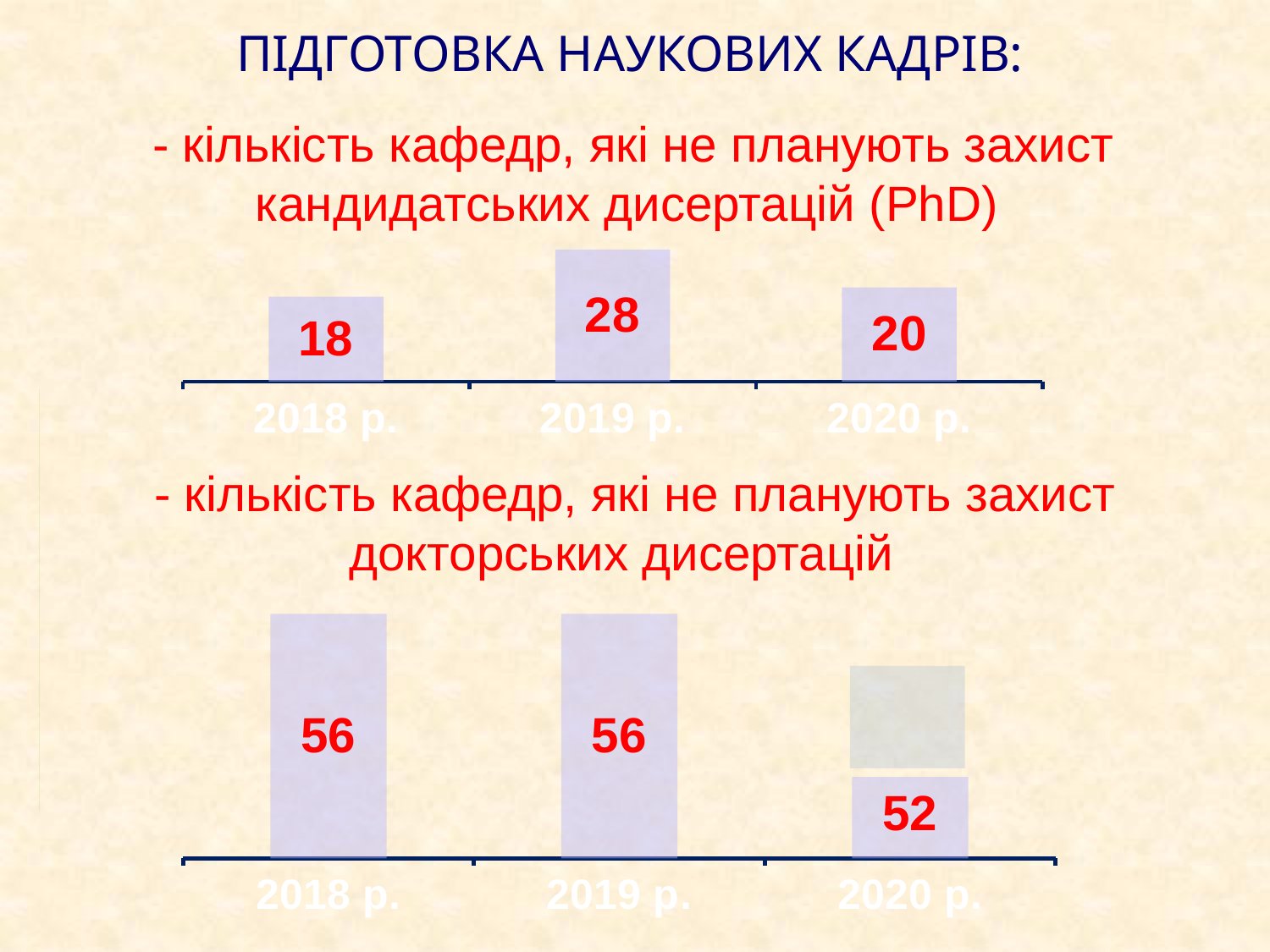
What type of chart is the top chart on the slide? bar chart In the top chart (кандидатських дисертацій (PhD)), which year has the highest value? 2019 р. In the top chart (кандидатських дисертацій (PhD)), what is the difference between the values for 2019 р. and 2020 р.? 8 In the top chart (кандидатських дисертацій (PhD)), what is the value for 2019 р.? 28 In the bottom chart (докторських дисертацій), what is the value for 2020 р.? 52 In the top chart (кандидатських дисертацій (PhD)), what is the value for 2018 р.? 18 In the top chart (кандидатських дисертацій (PhD)), how many bars are plotted? 3 In the bottom chart (докторських дисертацій), what is the difference between the values for 2018 р. and 2020 р.? 4 In the bottom chart (докторських дисертацій), what is the value for 2018 р.? 56 In the bottom chart (докторських дисертацій), which year has the lowest value? 2020 р. In the bottom chart (докторських дисертацій), is the value for 2019 р. larger than, smaller than, or equal to the value for 2018 р.? equal In the top chart (кандидатських дисертацій (PhD)), which year has the lowest value? 2018 р.